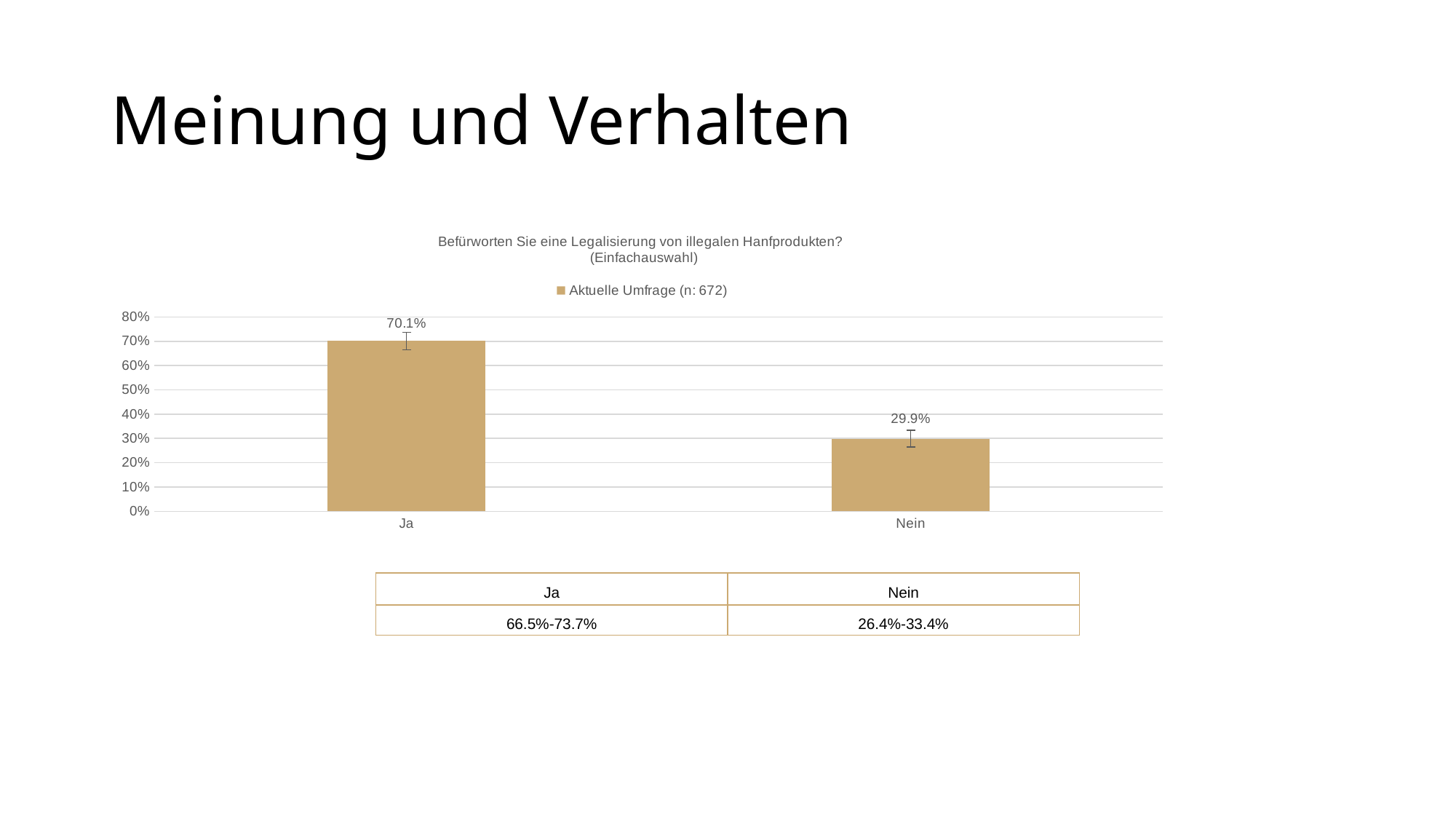
Which is larger, the value for "Ja" or the value for "Nein"? Ja Is the value for "Nein" greater or less than 40%? less How many categories are shown on the x axis? 2 What is the value for "Ja"? 70.1% How many series does the legend list? 1 Which category has the lowest value? Nein What is the difference between the values for "Ja" and "Nein"? 40.2% Which category has the highest value? Ja What kind of chart is shown? bar chart What is the series name shown in the legend? Aktuelle Umfrage (n: 672) What is the value for "Nein"? 29.9% Is the value for "Ja" greater or less than 60%? greater